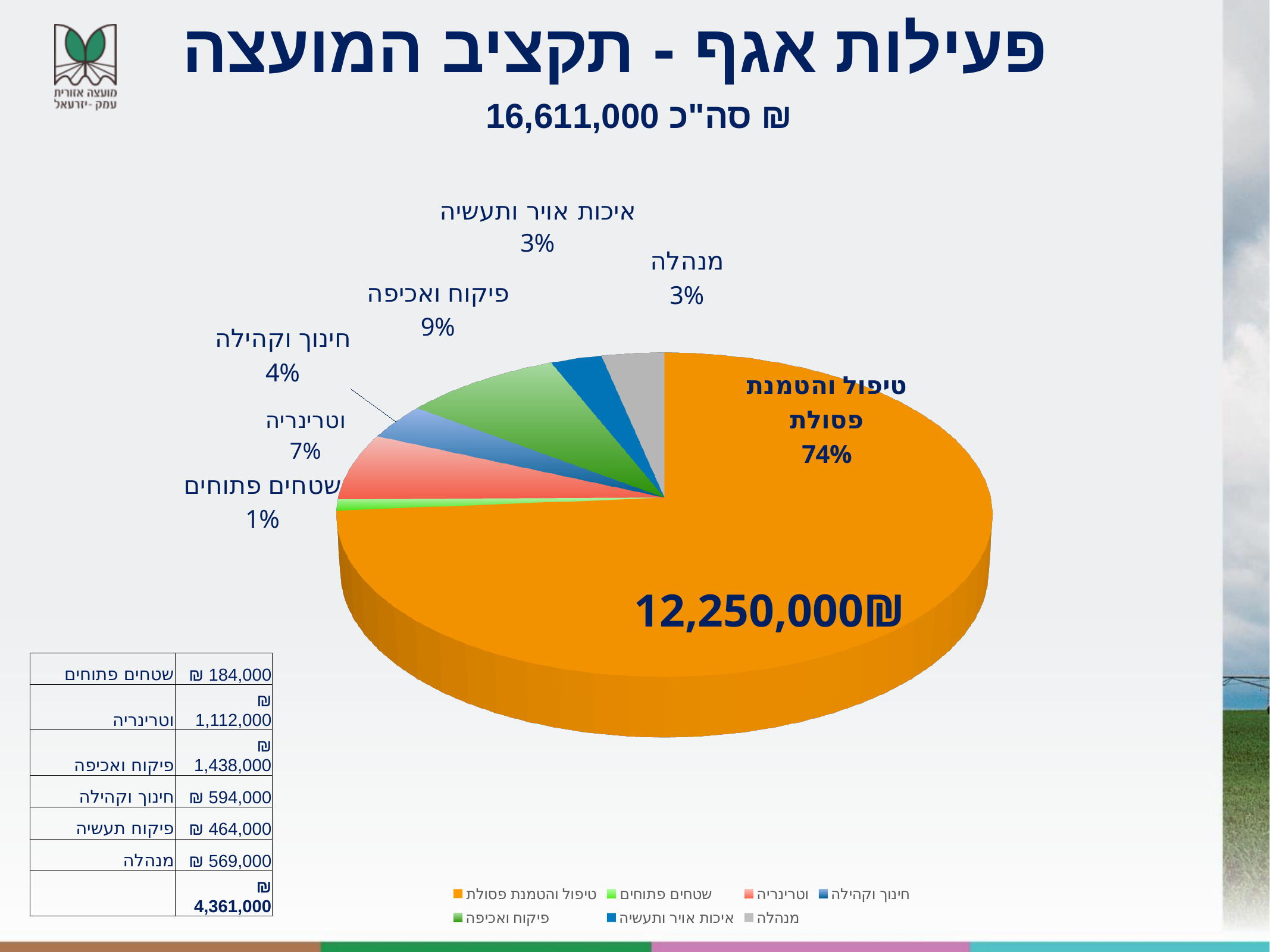
What percentage is shown for פיקוח ואכיפה? 9% Which has a larger share, וטרינריה or חינוך וקהילה? וטרינריה What is the difference in percentage points between טיפול והטמנת פסולת and פיקוח ואכיפה? 65 How many slices does the pie chart have? 7 What value is printed on the טיפול והטמנת פסולת slice of the pie? 12,250,000₪ What percentage is shown for חינוך וקהילה? 4% What percentage is shown for וטרינריה? 7% What total amount is stated in the subtitle above the chart? 16,611,000 ₪ What share of the pie does טיפול והטמנת פסולת represent? 74% Which category has the largest slice of the pie? טיפול והטמנת פסולת Which category has the smallest slice of the pie? שטחים פתוחים What kind of chart is shown on the slide? pie chart